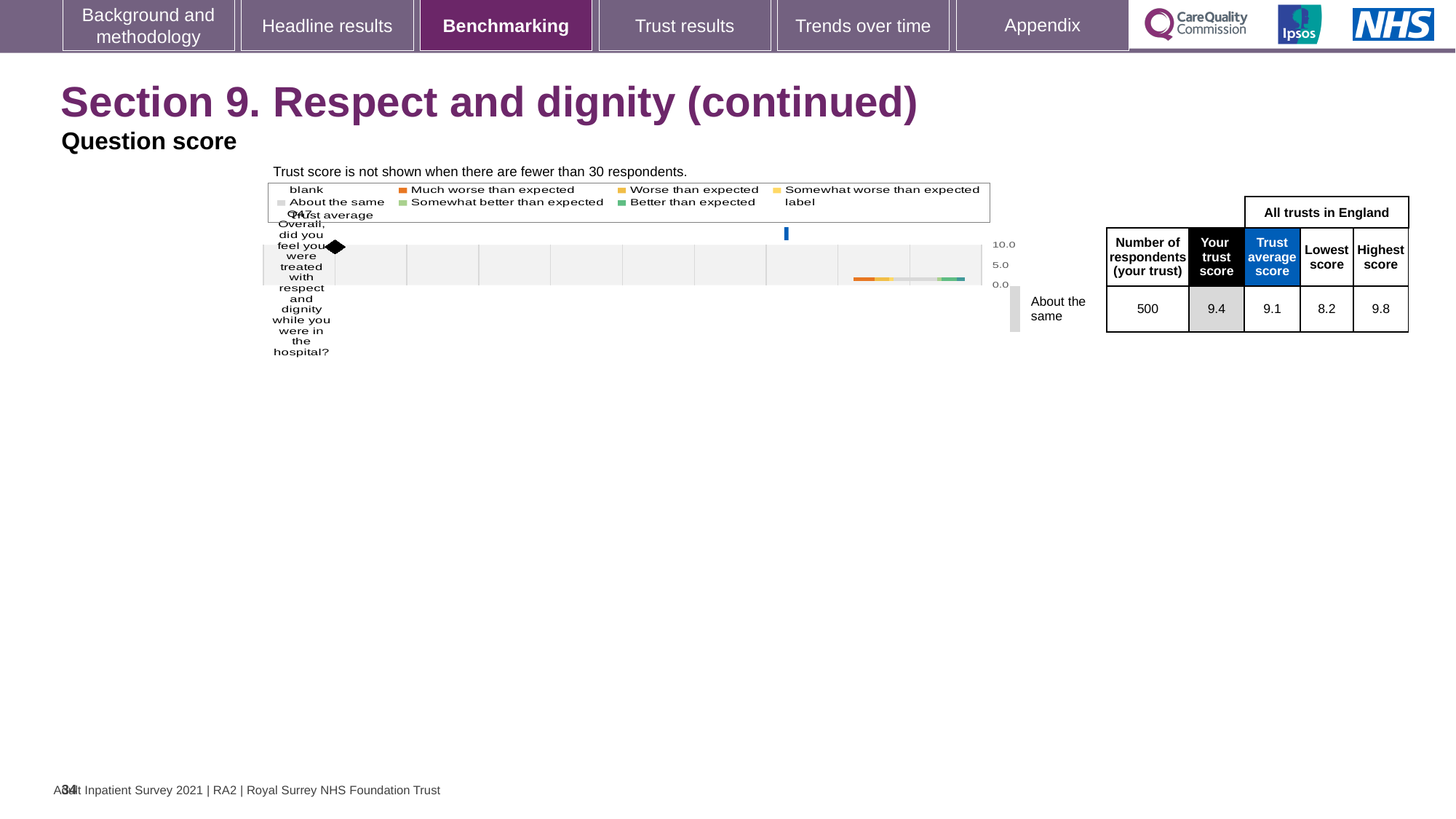
In the table beside the chart, what is the 'Trust average score' for all trusts in England? 9.1 What colour does the legend use for 'Much worse than expected'? orange What kind of chart is shown on the slide? bar chart In the table beside the chart, what is the 'Lowest score' among all trusts in England? 8.2 What is the difference between the highest score and the lowest score among all trusts in England? 1.6 Which is larger, the trust's score or the trust average score? the trust's score What is the highest tick value shown on the chart's axis? 10.0 In the table beside the chart, what is 'Your trust score' for Q47? 9.4 Is the trust's score for Q47 greater or less than 5.0? greater In the table beside the chart, how many respondents did the trust have for this question? 500 In the table beside the chart, what is the 'Highest score' among all trusts in England? 9.8 How many survey questions are plotted on the chart? 1